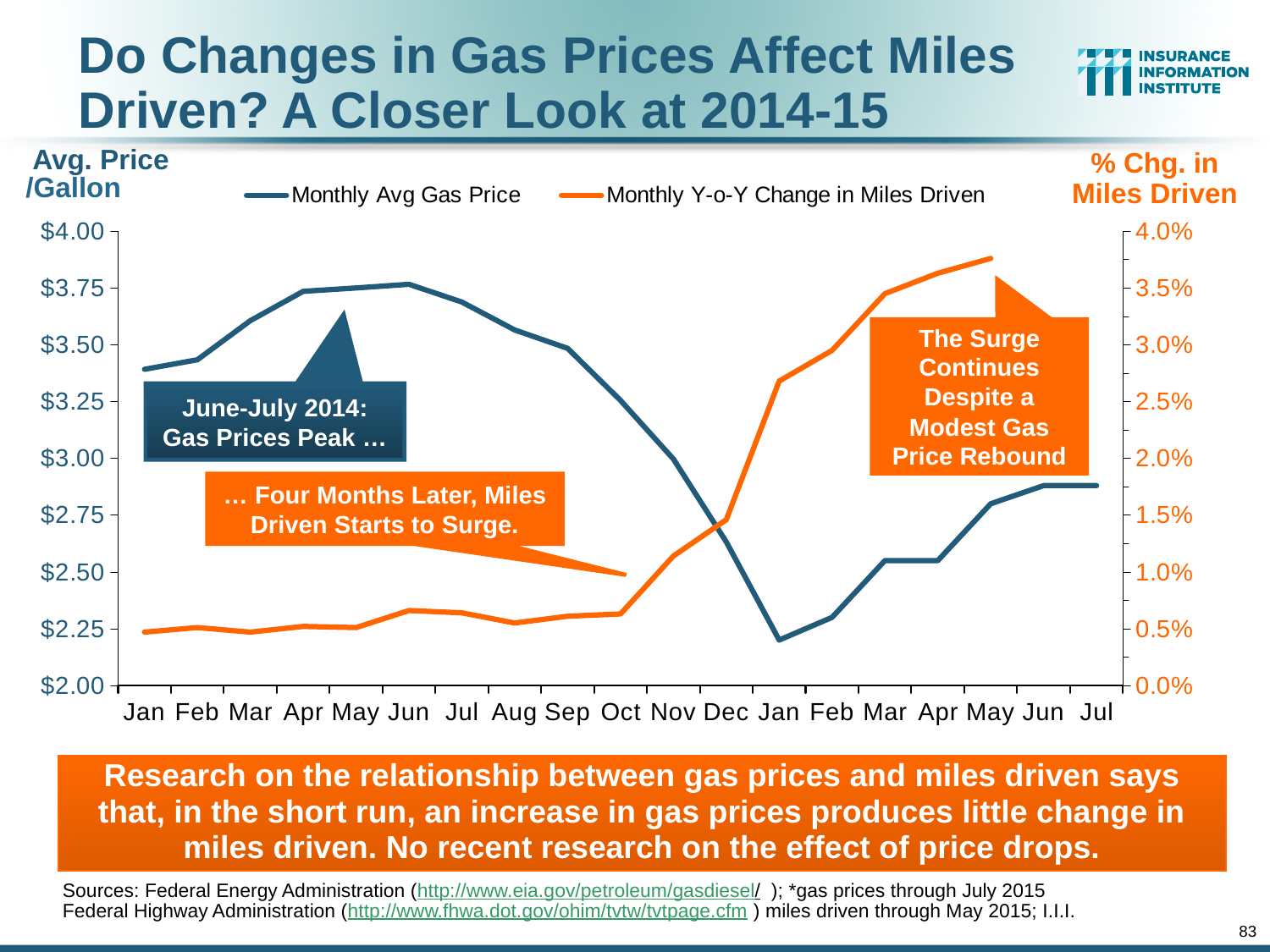
Which month shows the highest Monthly Y-o-Y Change in Miles Driven? May (the second May, 2015) Is the Monthly Avg Gas Price for Dec greater or less than $3.00? less Which month shows the lowest Monthly Avg Gas Price? Jan (the second Jan, 2015) Is the Monthly Y-o-Y Change in Miles Driven for the second Mar on the x axis greater or less than 3.0%? greater Does the Monthly Avg Gas Price rise or fall from the first Jun to the second Jan on the x axis? Fall Which is higher: the Monthly Avg Gas Price in the first Jun or in the second Jan on the x axis? The first Jun Is the Monthly Avg Gas Price for the first Jan on the x axis greater or less than $3.25? greater How many month labels are shown along the x axis of the chart? 19 What kind of chart is shown on the slide? Line chart How many series does the chart legend list? 2 What is the title of the right-hand vertical axis? % Chg. in Miles Driven